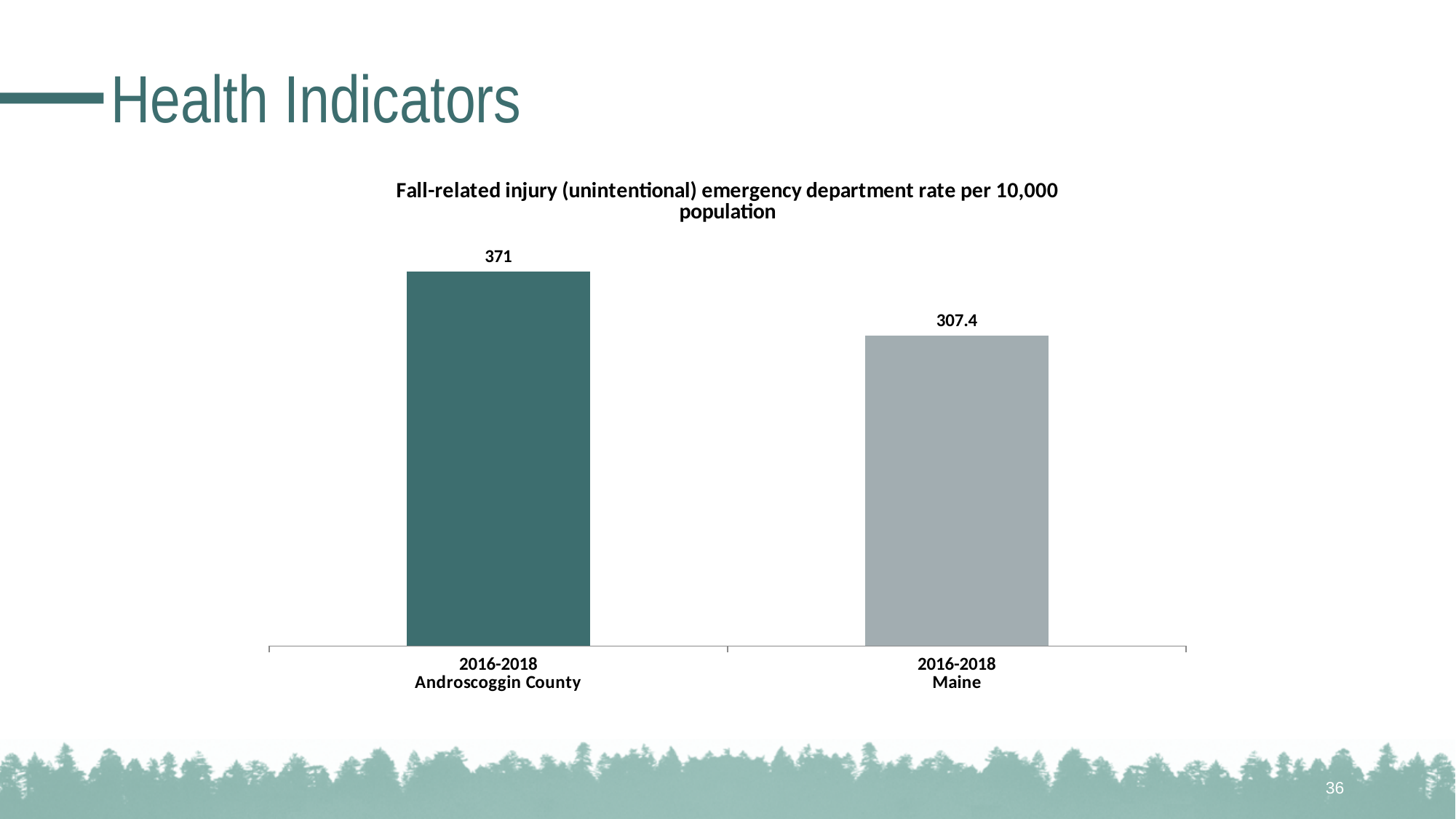
What is the title of the chart? Fall-related injury (unintentional) emergency department rate per 10,000 population Which category has the higher fall-related injury emergency department rate, Androscoggin County or Maine? Androscoggin County What kind of chart is shown on the slide? bar chart How many bars are shown in the chart? 2 What is the fall-related injury emergency department rate per 10,000 population for Androscoggin County (2016-2018)? 371 What time period do both bars in the chart cover? 2016-2018 Is the rate for Androscoggin County larger or smaller than the rate for Maine? larger What is the difference between the Androscoggin County rate and the Maine rate? 63.6 What is the fall-related injury emergency department rate per 10,000 population for Maine (2016-2018)? 307.4 Which category has the lower fall-related injury emergency department rate? Maine